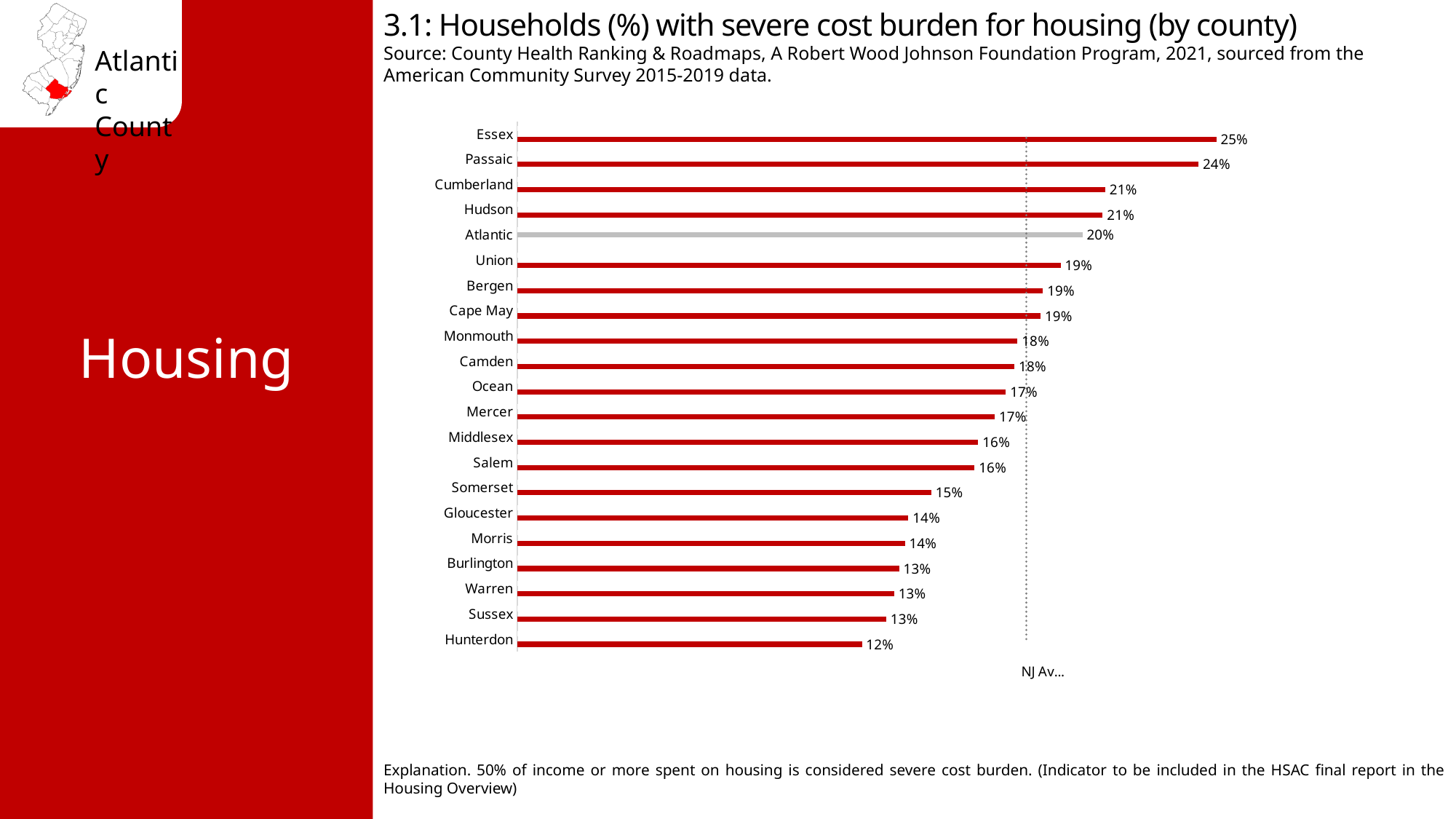
Which county has the lowest percentage of households with severe housing cost burden? Hunterdon What is the value shown for Cape May County? 19% What is the percentage of households with severe cost burden for housing in Atlantic County? 20% Which has a higher value, Atlantic or Union? Atlantic Which county has the highest percentage of households with severe housing cost burden? Essex What is the difference in percentage points between Essex and Hunterdon? 13 percentage points What is the value shown for Essex County? 25% What type of chart is shown on the slide? Bar chart What is the difference in percentage points between Passaic and Atlantic? 4 percentage points What is the value shown for Hunterdon County? 12% How many counties are shown in the chart? 21 Which county's bar is coloured grey instead of red? Atlantic